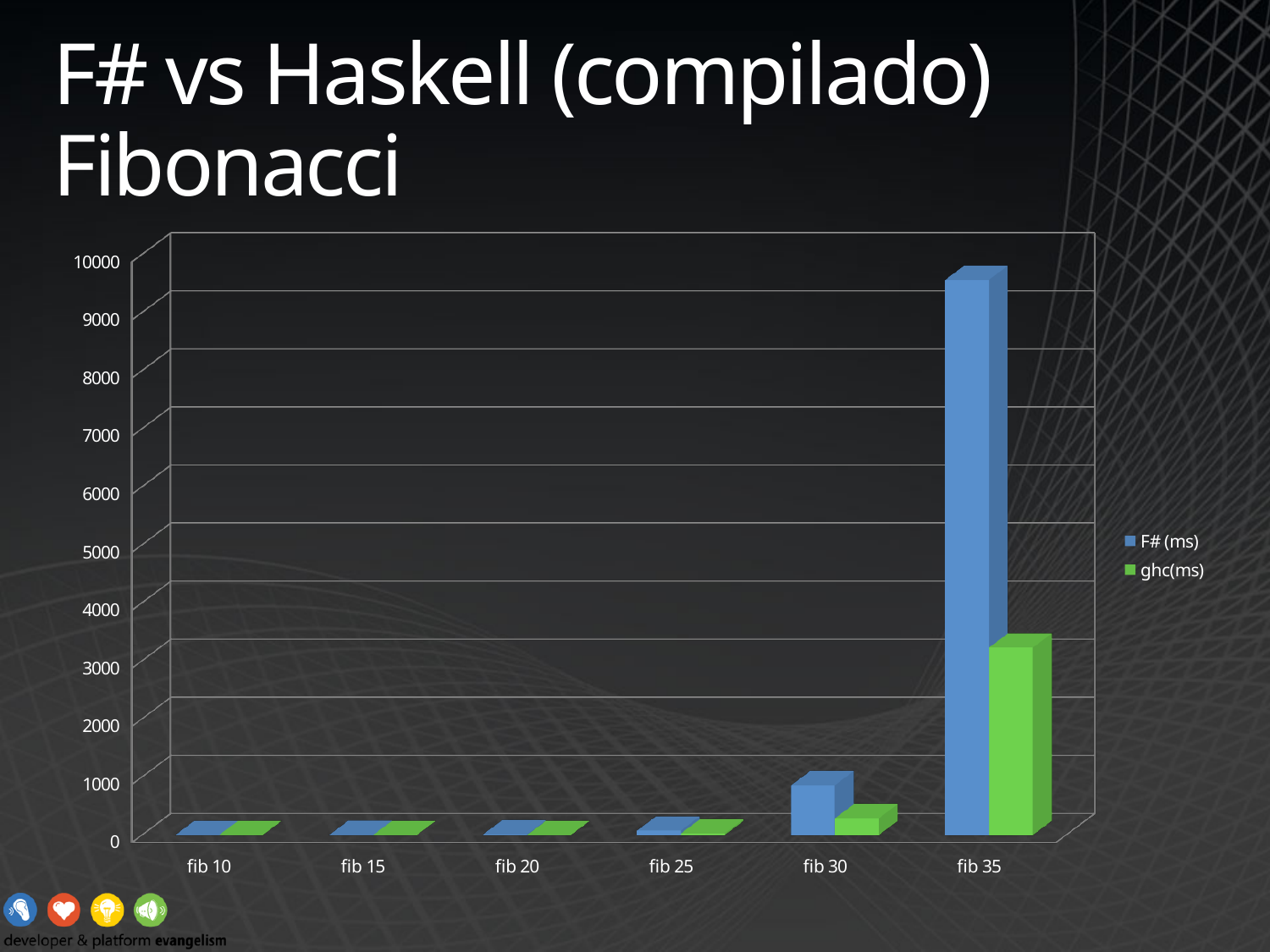
Do the F# (ms) values rise or fall as you move from fib 10 to fib 35 along the x axis? rise What are the two series names listed in the legend? F# (ms) and ghc(ms) What kind of chart is shown on the slide? bar chart For fib 35, which series has the larger value, F# (ms) or ghc(ms)? F# (ms) How many categories are shown on the x axis? 6 Is the F# (ms) value for fib 30 greater or less than 2000? less Is the ghc(ms) value for fib 35 greater or less than 2000? greater Which category has the highest F# (ms) value? fib 35 How many series does the legend list? 2 Which category has the highest ghc(ms) value? fib 35 For fib 30, which series has the larger value, F# (ms) or ghc(ms)? F# (ms) Is the F# (ms) value for fib 35 greater or less than 8000? greater